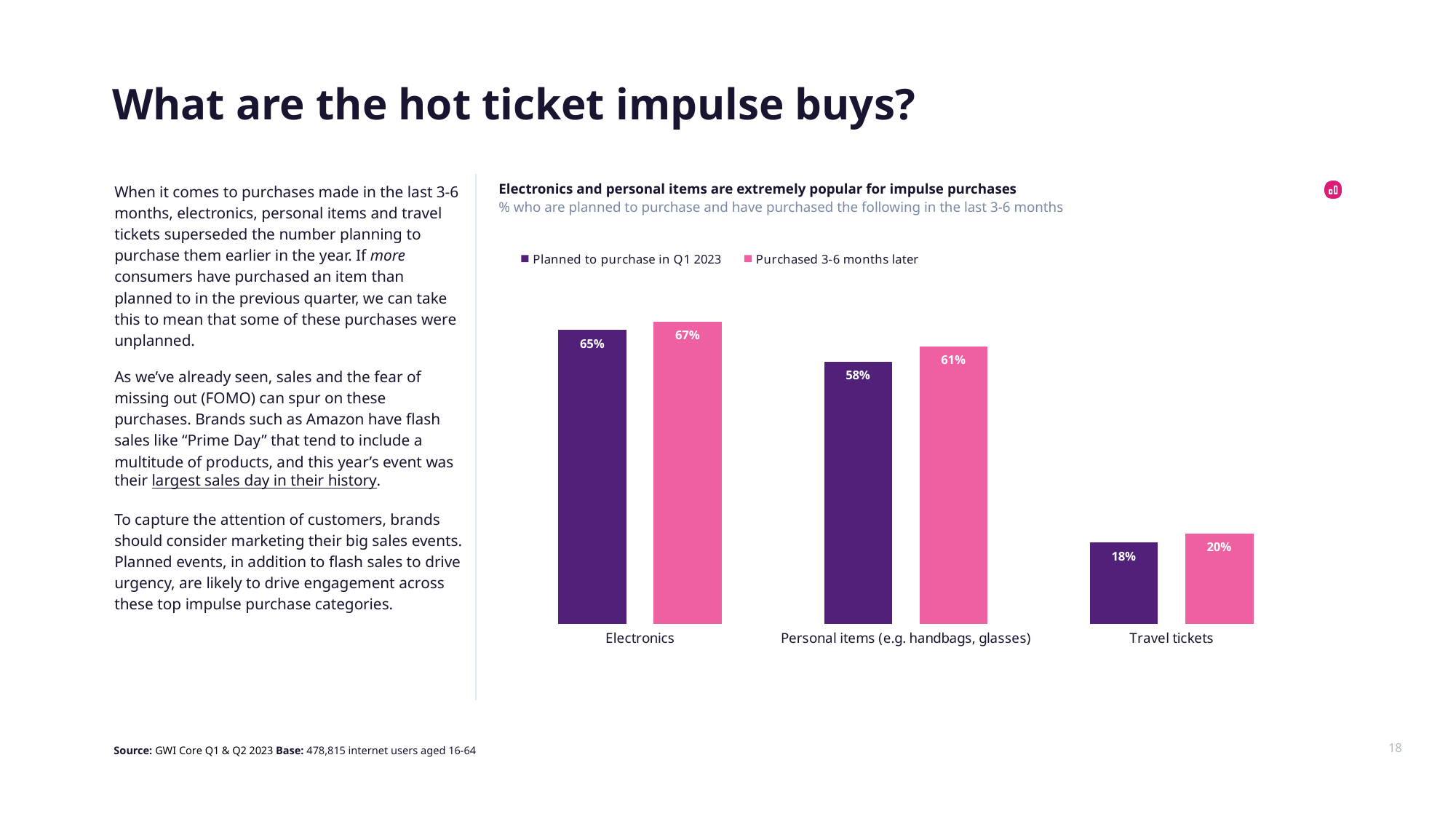
What kind of chart is shown on the slide? Bar chart Which category has the lowest value in the 'Planned to purchase in Q1 2023' series? Travel tickets What is the value for Travel tickets in the 'Planned to purchase in Q1 2023' series? 18% For Travel tickets, which is larger: 'Planned to purchase in Q1 2023' or 'Purchased 3-6 months later'? Purchased 3-6 months later How many categories are shown on the x axis of the chart? 3 How many series does the chart legend list? 2 What is the value for Electronics in the 'Planned to purchase in Q1 2023' series? 65% What is the difference between the Electronics and Travel tickets values in the 'Purchased 3-6 months later' series? 47% What is the value for Personal items (e.g. handbags, glasses) in the 'Purchased 3-6 months later' series? 61% Which category has the highest value in the 'Purchased 3-6 months later' series? Electronics What is the difference between the 'Purchased 3-6 months later' and 'Planned to purchase in Q1 2023' values for Personal items (e.g. handbags, glasses)? 3% What is the title of the chart? Electronics and personal items are extremely popular for impulse purchases